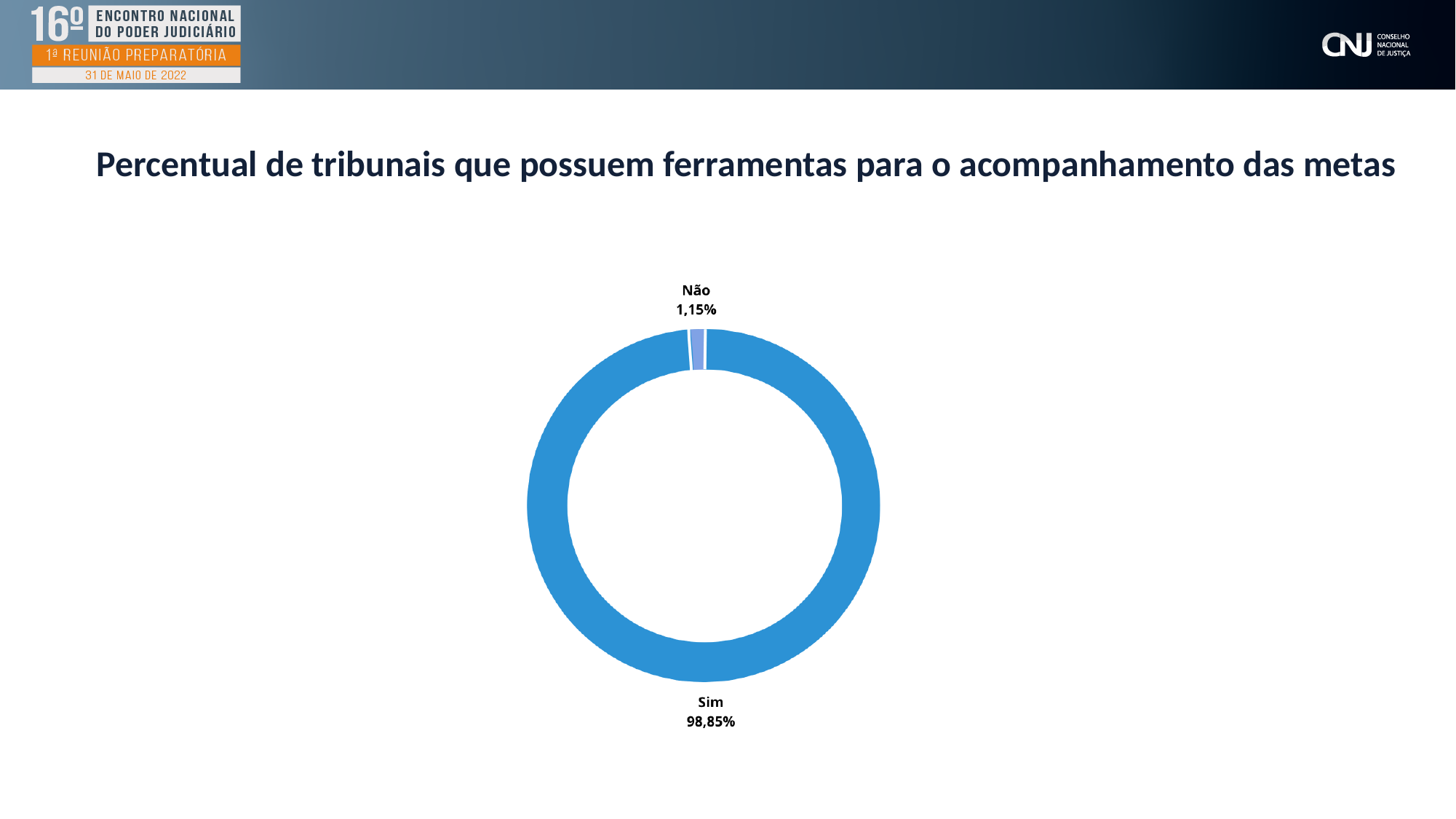
What kind of chart is shown on the slide? Doughnut (pie) chart What percentage of tribunals answered "Sim"? 98,85% Which is larger, the share for "Sim" or the share for "Não"? Sim Which category has the smallest share of the chart? Não What is the title of the chart on the slide? Percentual de tribunais que possuem ferramentas para o acompanhamento das metas What percentage of tribunals answered "Não"? 1,15% What is the difference in percentage points between "Sim" and "Não"? 97,70 Which category is shown in the darker blue colour? Sim Which category has the largest share of the chart? Sim How many categories are shown in the chart? 2 What is the total of the two percentages shown in the chart? 100%